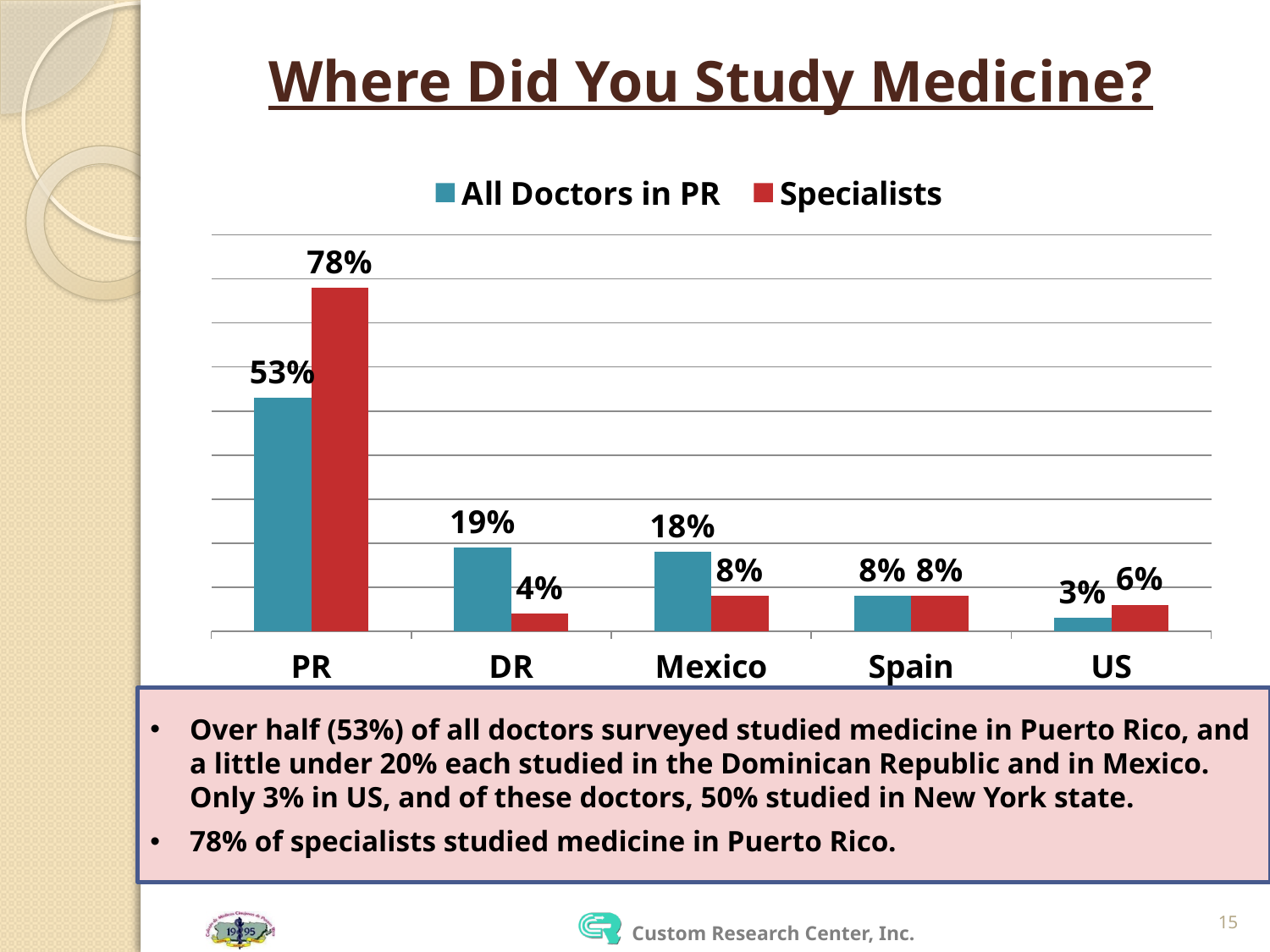
Which category has the lowest value for All Doctors in PR? US Which is larger for DR: All Doctors in PR or Specialists? All Doctors in PR What kind of chart is shown on the slide? Bar chart What is the value for All Doctors in PR for Mexico? 18% What is the value for Specialists in DR? 4% What percentage of All Doctors in PR studied medicine in PR? 53% What percentage of Specialists studied medicine in PR? 78% How many series does the legend list? 2 How many categories are shown on the x axis? 5 Which category has the highest value for Specialists? PR What is the difference between the Specialists and All Doctors in PR values for PR? 25% What colour represents the Specialists series? Red